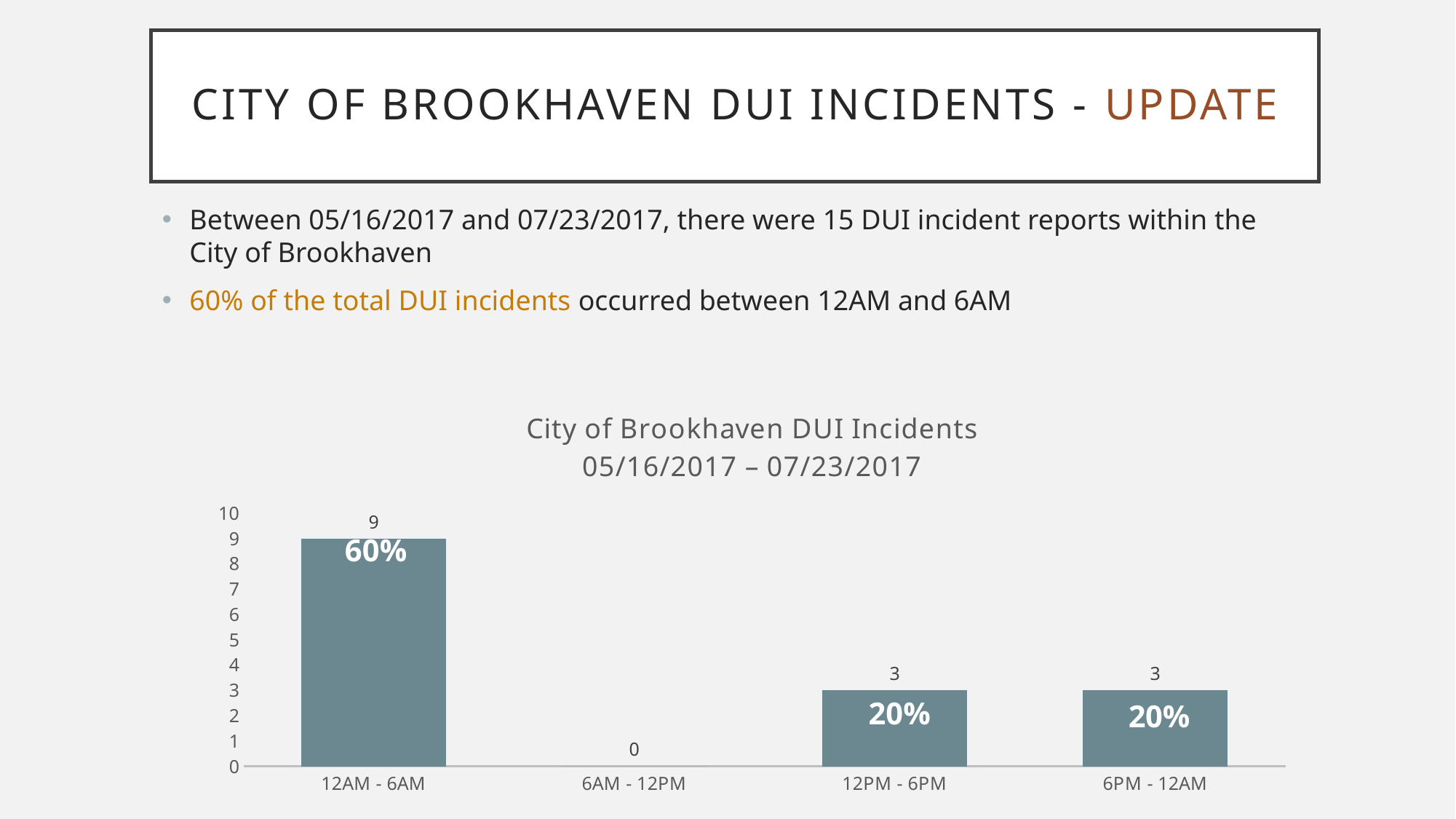
Which has more DUI incidents, 12AM - 6AM or 6PM - 12AM? 12AM - 6AM How many DUI incidents are shown for the 6AM - 12PM period? 0 Which time period has the lowest number of DUI incidents? 6AM - 12PM Which time period has the highest number of DUI incidents? 12AM - 6AM How many time period categories are shown on the x axis? 4 What is the title of the chart? City of Brookhaven DUI Incidents 05/16/2017 – 07/23/2017 What kind of chart is shown on the slide? Bar chart What is the difference in DUI incidents between the 12AM - 6AM period and the 12PM - 6PM period? 6 How many DUI incidents are shown for the 12PM - 6PM period? 3 What percentage label is shown on the 6PM - 12AM bar? 20% How many DUI incidents are shown for the 12AM - 6AM period? 9 Is the value for 12AM - 6AM greater or less than 5? greater